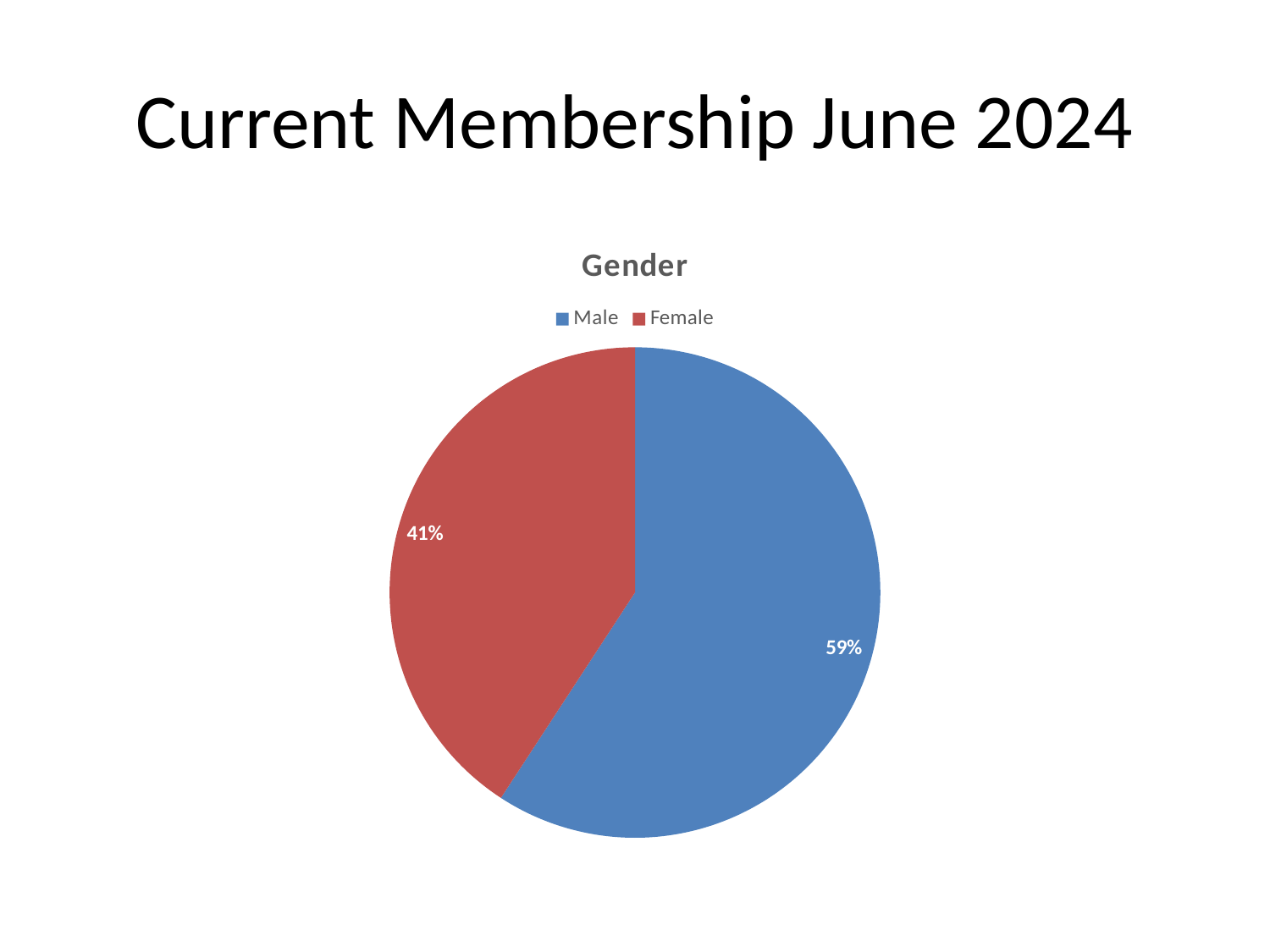
What percentage of the membership is Male? 59% What share of the pie does the Female slice represent? 41% What kind of chart is shown on the slide? Pie chart What is the title of the chart? Gender Which is larger, the Male share or the Female share? Male What is the difference in percentage points between the Male and Female shares? 18 What percentage of the membership is Female? 41% How many entries does the legend list? 2 What colour represents Female in the pie chart? Red How many categories does the pie chart show? 2 Which gender has the smallest share of the membership? Female Which gender has the largest share of the membership? Male